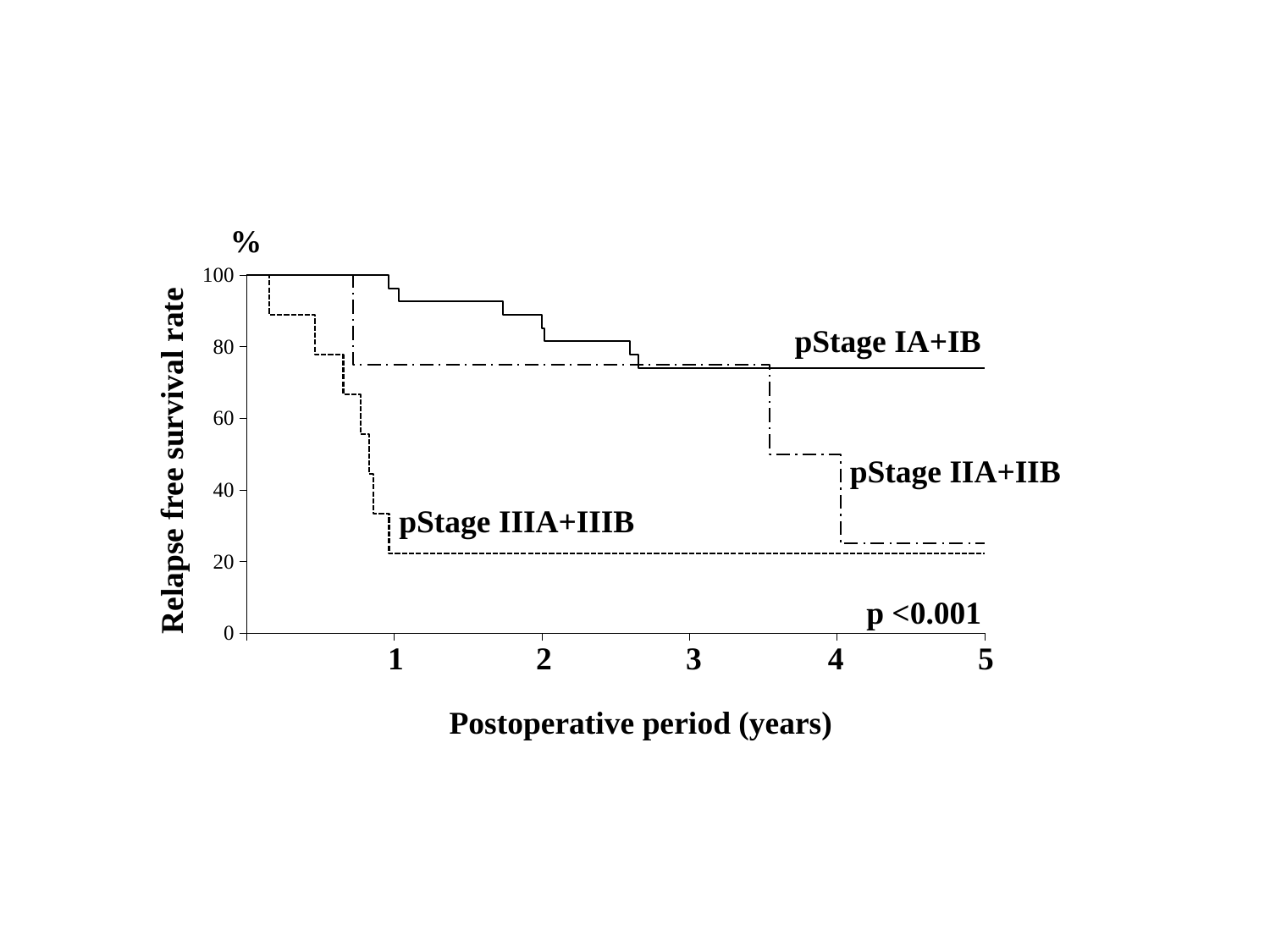
How many series (patient groups) are plotted on the chart? 3 At 5 years, is the relapse free survival rate for pStage IIIA+IIIB greater or less than 40? less Which group has the lowest relapse free survival rate at 3 years? pStage IIIA+IIIB At 3 years, is the relapse free survival rate for pStage IIA+IIB greater or less than 60? greater At 2 years, which group has the higher relapse free survival rate: pStage IIA+IIB or pStage IIIA+IIIB? pStage IIA+IIB Do the relapse free survival rates rise or fall as the postoperative period increases? fall What kind of chart is shown on the slide? line chart What p-value is shown on the chart? p <0.001 At 5 years, is the relapse free survival rate for pStage IA+IB greater or less than 60? greater Which group has the highest relapse free survival rate at 5 years? pStage IA+IB What is the label of the x axis? Postoperative period (years)